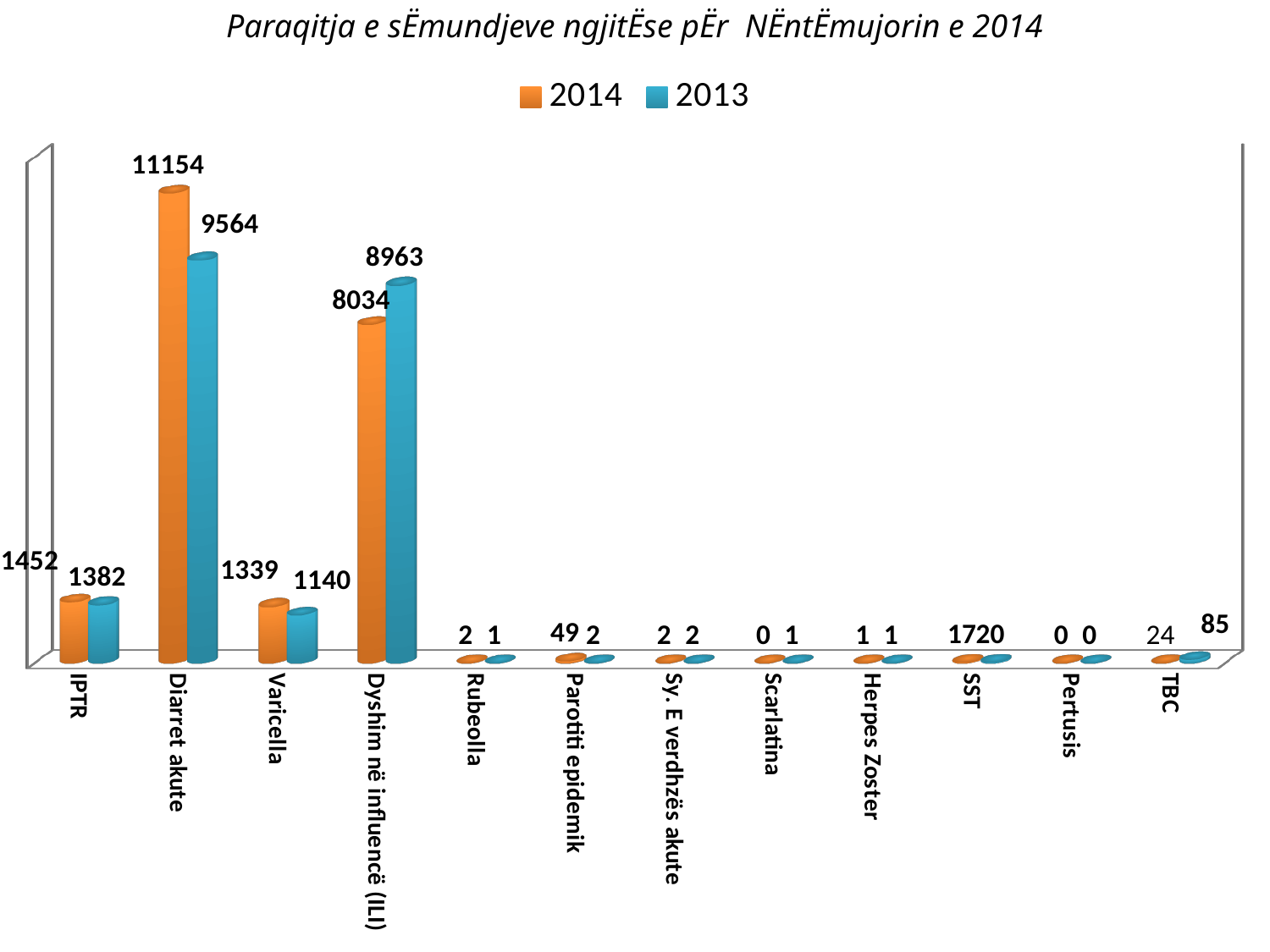
How many series does the legend list? 2 How many categories are shown on the x axis? 12 What is the 2014 value for Diarret akute? 11154 What is the 2013 value for TBC? 85 What kind of chart is shown on the slide? Bar chart What is the difference between the 2014 and 2013 values for Diarret akute? 1590 What is the 2013 value for Dyshim në influencë (ILI)? 8963 For TBC, which year has the larger value, 2014 or 2013? 2013 What is the 2014 value for Parotiti epidemik? 49 Which category has the highest 2014 value? Diarret akute For Varicella, which year has the larger value, 2014 or 2013? 2014 What is the difference between the 2013 and 2014 values for Dyshim në influencë (ILI)? 929